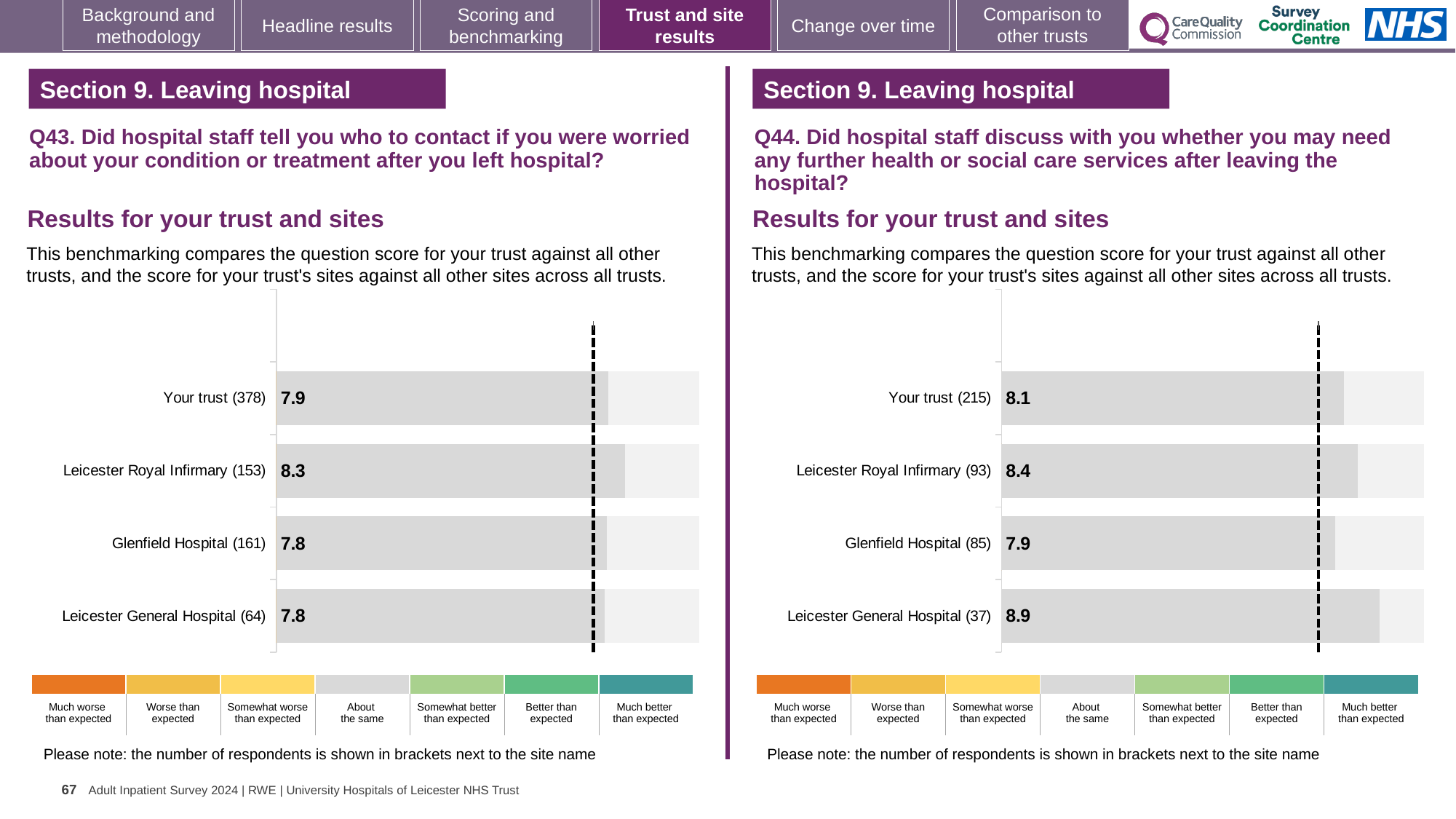
In the Q43 chart (left), how many bars are plotted? 4 In the Q44 chart (right), which site or trust has the lowest score? Glenfield Hospital (85) How many categories does the colour key below each chart list, from 'Much worse than expected' to 'Much better than expected'? 7 In the Q43 chart (left), what is the score for Your trust (378)? 7.9 In the Q44 chart (right), what is the score for Glenfield Hospital (85)? 7.9 In the Q44 chart (right), which is larger: the score for Your trust (215) or the score for Leicester Royal Infirmary (93)? Leicester Royal Infirmary (93) In the Q43 chart (left), which site or trust has the highest score? Leicester Royal Infirmary (153) In the Q43 chart (left), what is the difference between the scores for Leicester Royal Infirmary (153) and Glenfield Hospital (161)? 0.5 What type of chart is used on the left side of the slide for Q43? Bar chart In the Q43 chart (left), what is the score for Leicester Royal Infirmary (153)? 8.3 In the Q44 chart (right), what is the difference between the scores for Leicester General Hospital (37) and Your trust (215)? 0.8 In the Q44 chart (right), what is the score for Leicester General Hospital (37)? 8.9